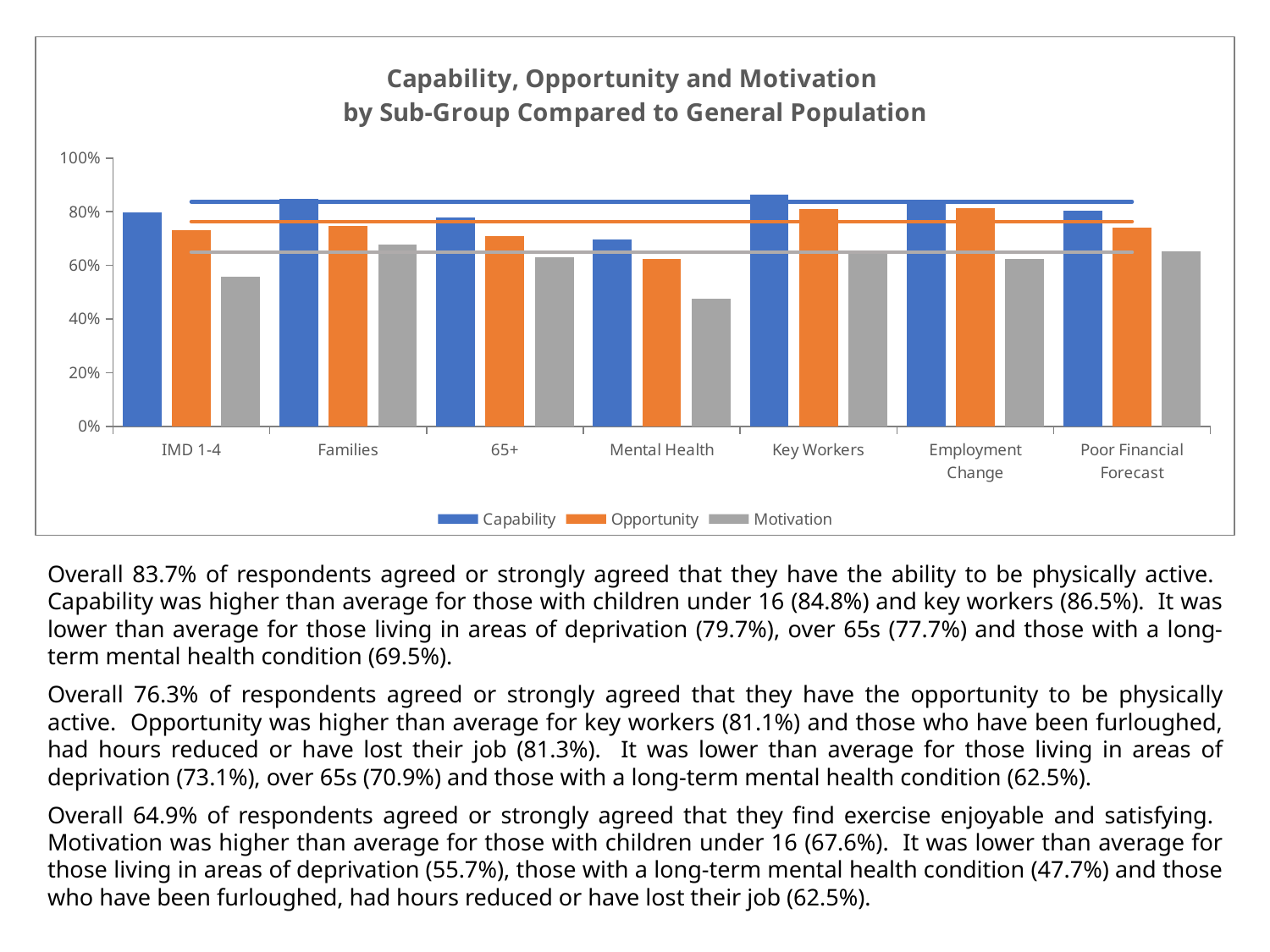
Is the Motivation value for Mental Health greater or less than 60%? less For IMD 1-4, which is larger: the Capability value or the Motivation value? Capability How many sub-groups are shown along the x axis of the chart? 7 Is the Capability value for Mental Health greater or less than 80%? less Which sub-group has the lowest Capability value? Mental Health Which sub-group has the lowest Motivation value? Mental Health Which sub-group has the lowest Opportunity value? Mental Health How many series does the chart's legend list? 3 Is the Capability value for Key Workers greater or less than 80%? greater What kind of chart is shown on the slide? Bar chart For Mental Health, which is larger: the Opportunity value or the Motivation value? Opportunity Which colour represents the Opportunity series in the chart? Orange